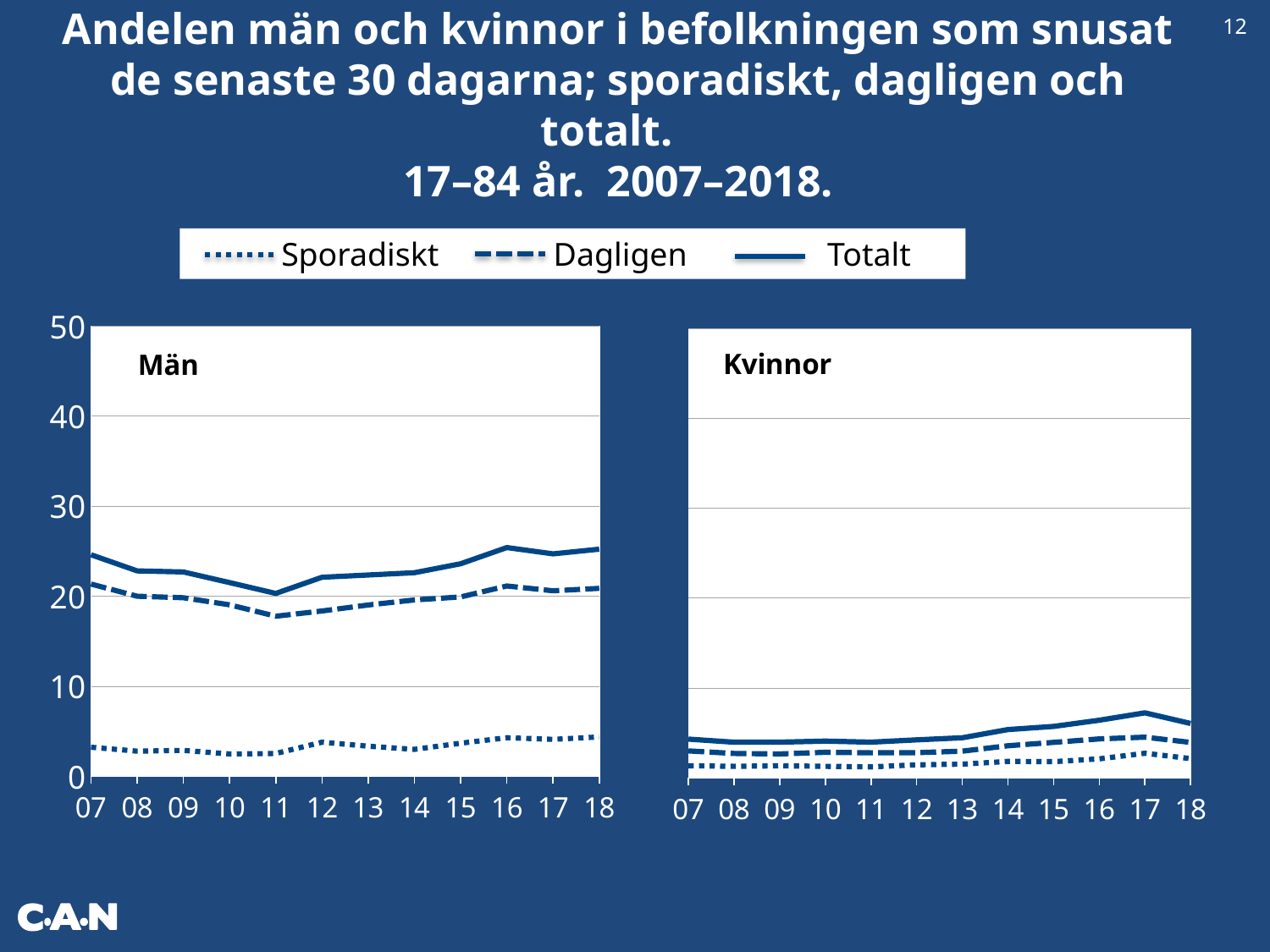
In the Män chart, does the Totalt line rise or fall from 2011 to 2016? rise Which is larger in 2018: the Totalt value in the Män chart or the Totalt value in the Kvinnor chart? Män In the Kvinnor chart, which year has the highest Totalt value? 17 In the Män chart, is the Sporadiskt value for 2018 greater or less than 10? less How many years are plotted on the x axis of the Kvinnor chart? 12 In the Män chart, which year has the lowest Totalt value? 11 In the Män chart, is the Totalt value for 2011 greater or less than 30? less What kind of chart is the Män chart? line chart In the Kvinnor chart, is the Totalt value for 2017 greater or less than 10? less How many series does the legend list? 3 Which series is shown with a dotted line in the legend? Sporadiskt